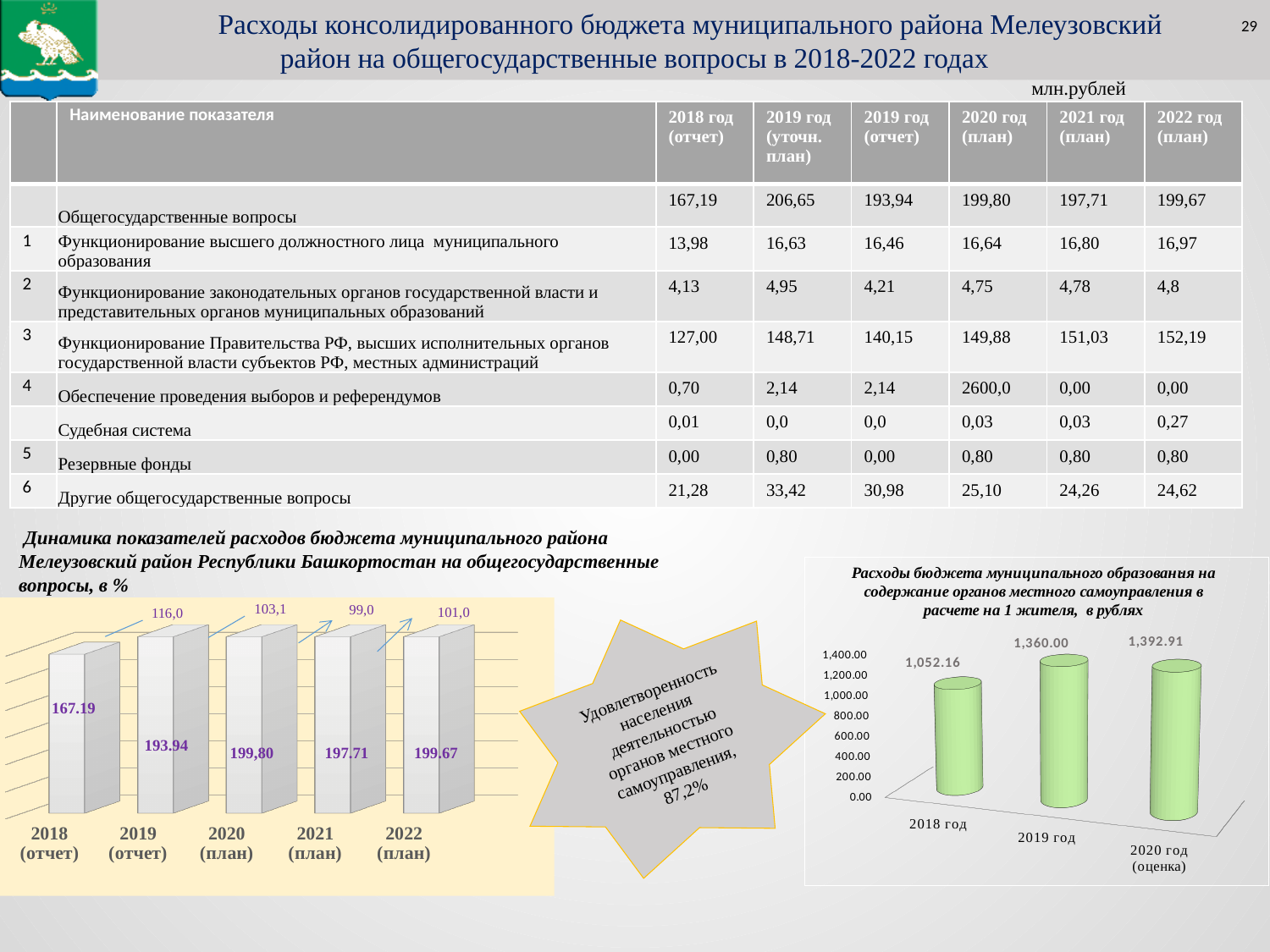
In the right chart (Расходы бюджета на содержание органов местного самоуправления в расчете на 1 жителя), which year has the lowest value? 2018 год In the left chart (Динамика показателей расходов бюджета), what is the value for 2018 (отчет)? 167.19 In the left chart (Динамика показателей расходов бюджета), what is the difference between the 2019 (отчет) value and the 2018 (отчет) value? 26.75 In the left chart (Динамика показателей расходов бюджета), how many bars are plotted? 5 In the left chart (Динамика показателей расходов бюджета), what percentage is shown above the 2019 bar? 116,0 In the right chart (Расходы бюджета на содержание органов местного самоуправления в расчете на 1 жителя), do the values rise or fall from 2018 to 2020? rise In the left chart (Динамика показателей расходов бюджета), which year has the lowest value? 2018 (отчет) In the right chart (Расходы бюджета на содержание органов местного самоуправления в расчете на 1 жителя), what is the value for 2018 год? 1,052.16 In the right chart (Расходы бюджета на содержание органов местного самоуправления в расчете на 1 жителя), what is the value for 2020 год (оценка)? 1,392.91 What kind of chart is the right chart (Расходы бюджета на содержание органов местного самоуправления в расчете на 1 жителя)? bar chart In the left chart (Динамика показателей расходов бюджета), which year has the highest value? 2020 (план) In the left chart (Динамика показателей расходов бюджета), what is the value for 2021 (план)? 197.71